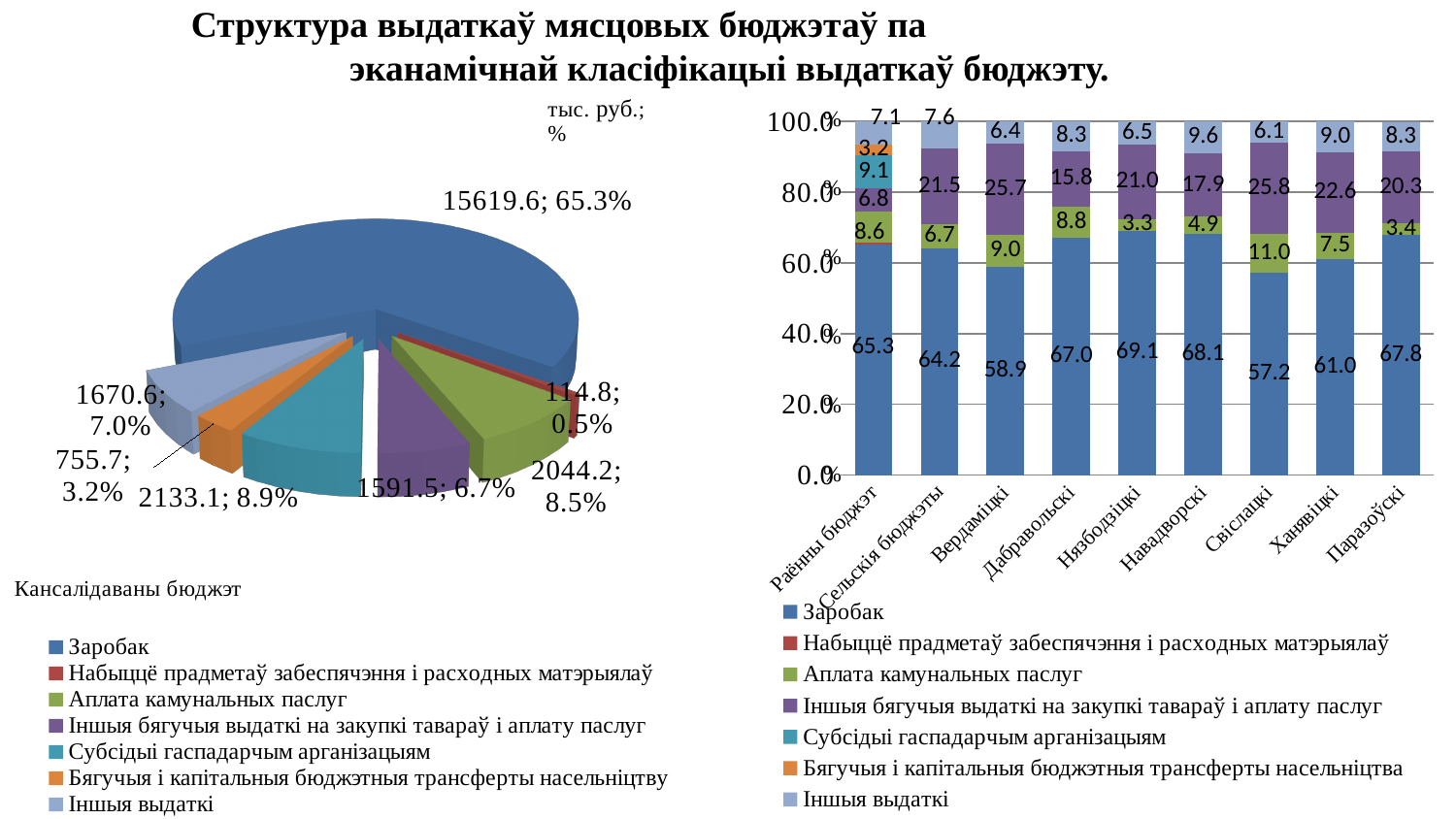
In the pie chart on the left, which category has the smallest slice? Набыццё прадметаў забеспячэння і расходных матэрыялаў In the pie chart on the left, what value and share are shown for Заробак? 15619.6; 65.3% What type of chart is shown on the left of the slide? Pie chart In the stacked bar chart on the right, how many categories are shown on the x axis? 9 In the stacked bar chart on the right, how many series does the legend list? 7 In the pie chart on the left, what is the difference between the values for Субсідыі гаспадарчым арганізацыям and Аплата камунальных паслуг? 88.9 In the pie chart on the left, what share does Субсідыі гаспадарчым арганізацыям have? 8.9% In the stacked bar chart on the right, what is the Заробак value for Нязбодзіцкі? 69.1 In the stacked bar chart on the right, which is larger: the Аплата камунальных паслуг value for Свіслацкі or for Паразоўскі? Свіслацкі In the stacked bar chart on the right, which category has the highest Іншыя выдаткі value? Навадворскі In the stacked bar chart on the right, which category has the lowest Заробак value? Свіслацкі In the stacked bar chart on the right, what is the difference between the Заробак values for Дабравольскі and Вердаміцкі? 8.1